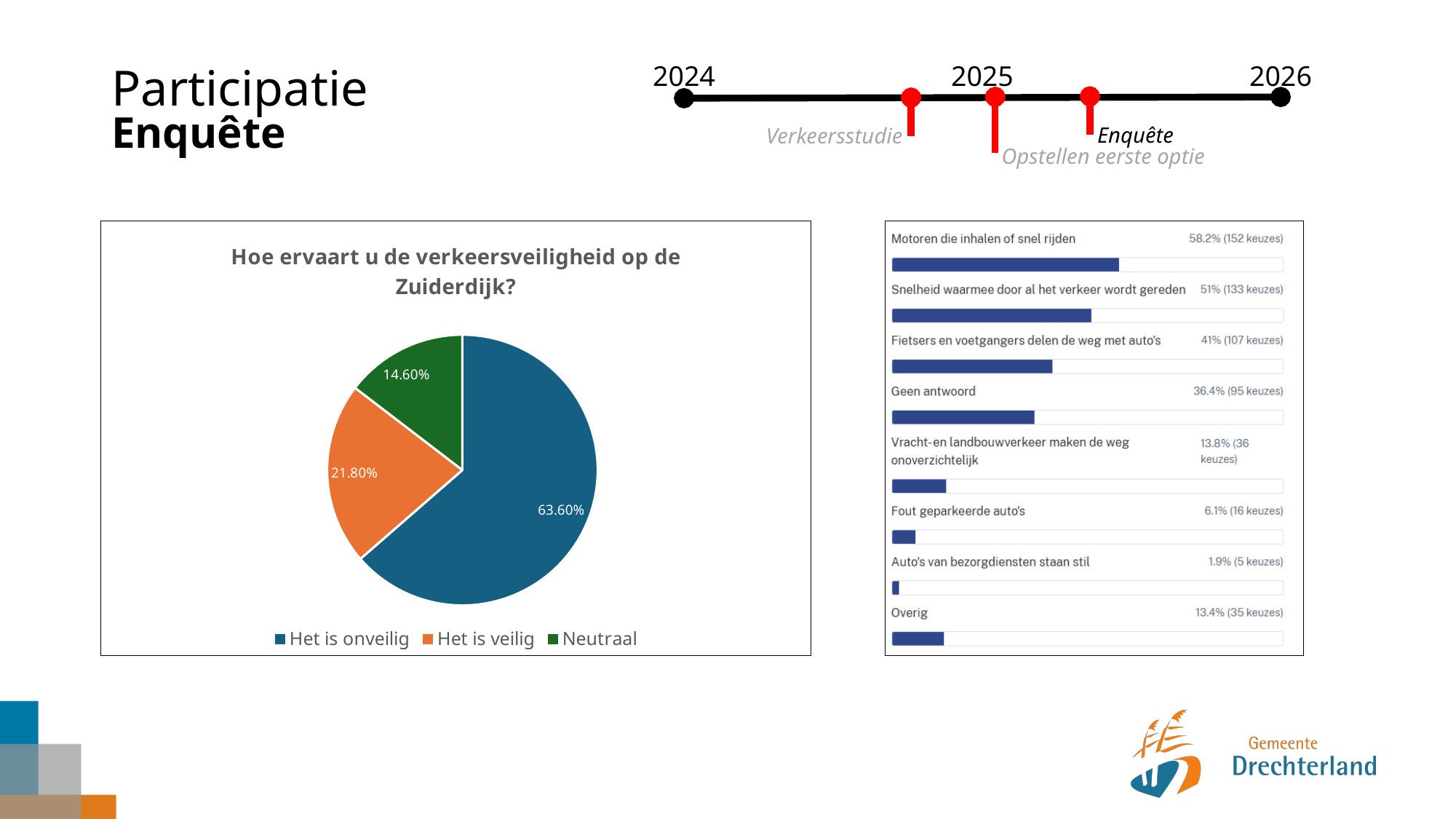
In the bar chart on the right, which category has the lowest value? Auto's van bezorgdiensten staan stil In the pie chart on the left, what is the difference between the shares for "Het is veilig" and "Neutraal"? 7.20% In the bar chart on the right, what value is shown for "Fout geparkeerde auto's"? 6.1% (16 keuzes) In the pie chart on the left, what share is labelled for "Neutraal"? 14.60% In the pie chart titled "Hoe ervaart u de verkeersveiligheid op de Zuiderdijk?", what share is labelled for "Het is onveilig"? 63.60% In the pie chart on the left, which category has the largest slice? Het is onveilig In the bar chart on the right, what value is shown for "Motoren die inhalen of snel rijden"? 58.2% (152 keuzes) In the bar chart on the right, how many categories are shown? 8 In the bar chart on the right, which is larger: "Geen antwoord" or "Overig"? Geen antwoord In the pie chart on the left, which category has the smallest slice? Neutraal In the pie chart on the left, how many entries does the legend list? 3 What kind of chart is shown on the right side of the slide? Bar chart